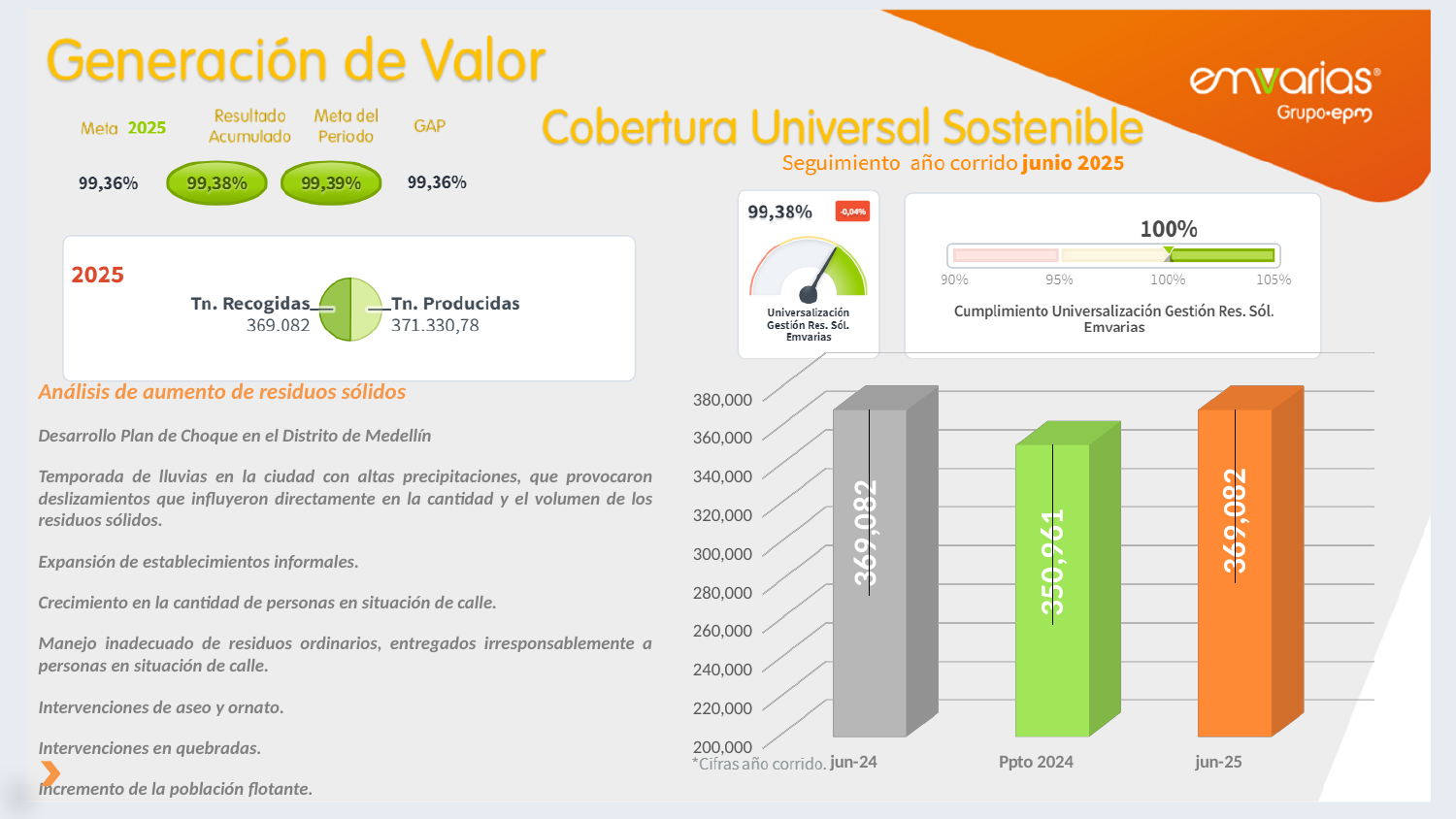
On the pie chart labelled 2025, what is the value for Tn. Recogidas? 369.082 On the bar chart at the bottom right, how many bars are plotted? 3 On the bar chart at the bottom right, which category has the lowest value? Ppto 2024 What kind of chart is shown at the bottom right of the slide? Bar chart On the bar chart at the bottom right, which is larger, the value for jun-25 or the value for Ppto 2024? jun-25 On the bar chart at the bottom right, what is the value for jun-25? 369,082 What value does the gauge chart labelled Universalización Gestión Res. Sól. Emvarias show? 99,38% On the pie chart labelled 2025, which slice is larger, Tn. Recogidas or Tn. Producidas? Tn. Producidas On the pie chart labelled 2025, what is the value for Tn. Producidas? 371.330,78 On the bar chart at the bottom right, what is the value for Ppto 2024? 350,961 On the bar chart at the bottom right, what is the difference between the jun-24 value and the Ppto 2024 value? 18,121 On the bar chart at the bottom right, what is the value for jun-24? 369,082